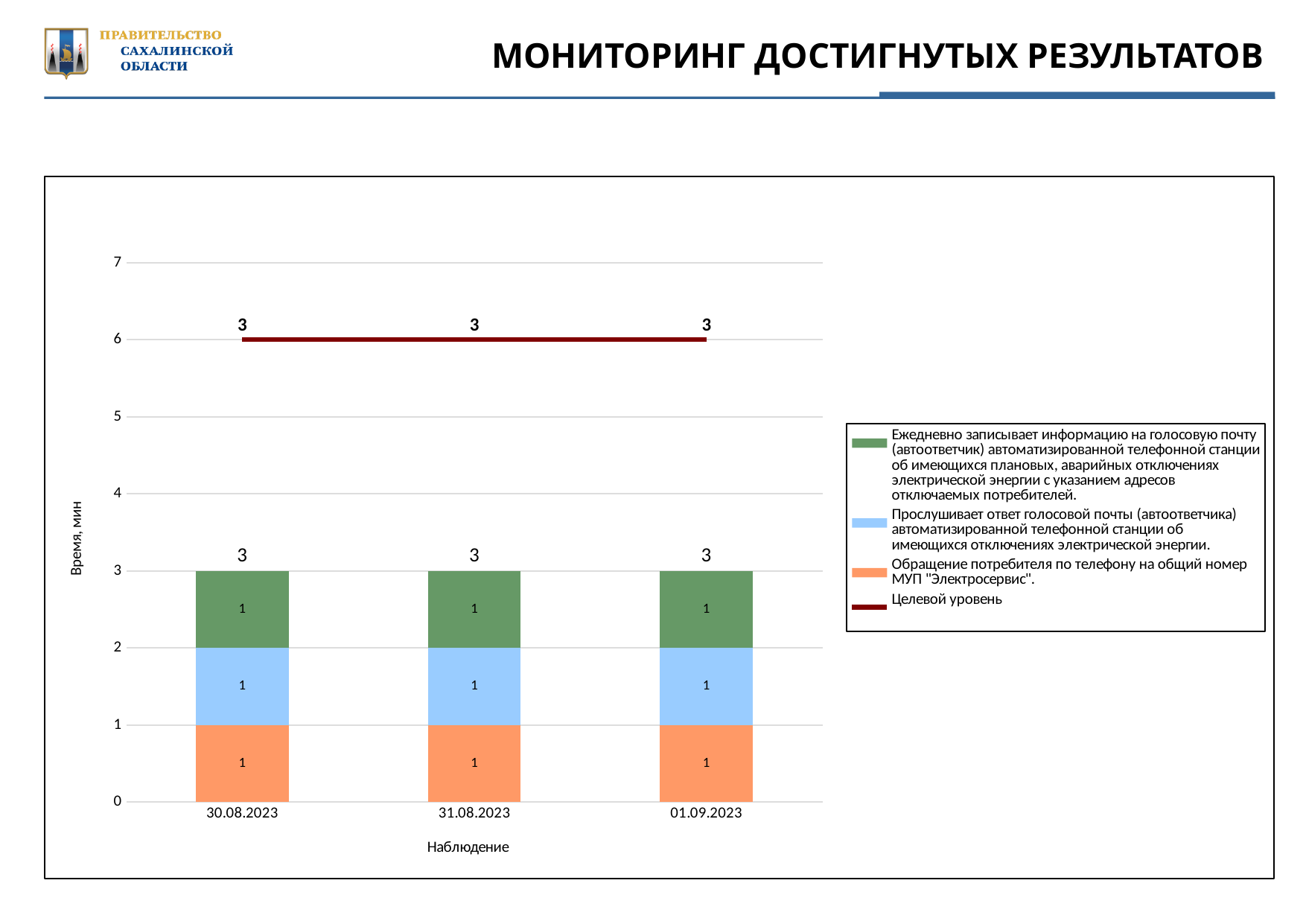
What is the title of the x axis of the chart? Наблюдение What kind of chart is shown on the slide? combination stacked bar and line chart What is the title of the y axis of the chart? Время, мин What is the value of the blue segment (Прослушивает ответ голосовой почты...) for 30.08.2023? 1 How many entries does the chart legend list? 4 What is the value of the green segment (Ежедневно записывает информацию на голосовую почту...) for 01.09.2023? 1 What value is labelled on the Целевой уровень line for 31.08.2023? 3 How many dates (categories) are shown on the x axis of the chart? 3 What is the value of the orange segment (Обращение потребителя по телефону на общий номер МУП "Электросервис") for 31.08.2023? 1 What is the total of the stacked bar for 30.08.2023? 3 Do the stacked bar totals rise, fall or stay the same from 30.08.2023 to 01.09.2023? stay the same Is the total of the stacked bar for 31.08.2023 greater or less than 5? less